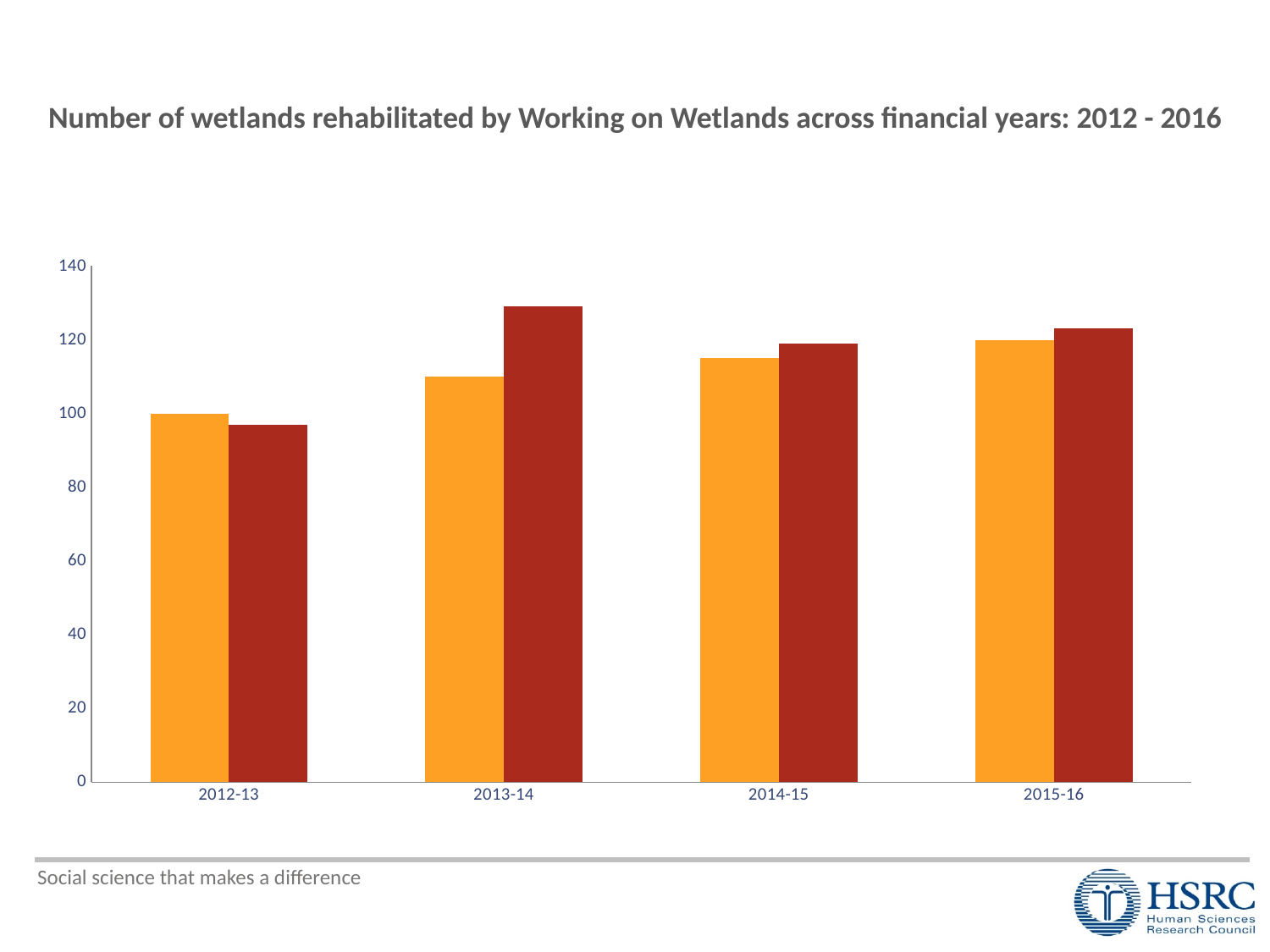
Is the value of the orange bar for 2014-15 greater or less than 120? less For 2013-14, which bar is taller, the orange bar or the dark red bar? the dark red bar Is the value of the dark red bar for 2015-16 greater or less than 120? greater How many financial years are shown on the x axis of the chart? 4 Which financial year has the lowest orange bar? 2012-13 What is the title of the chart? Number of wetlands rehabilitated by Working on Wetlands across financial years: 2012 - 2016 How many bars are plotted for each financial year in the chart? 2 Do the orange bars rise or fall from 2012-13 to 2015-16? rise What kind of chart is shown on the slide? bar chart Which financial year has the tallest bar in the chart? 2013-14 Is the value of the orange bar for 2013-14 greater or less than 100? greater